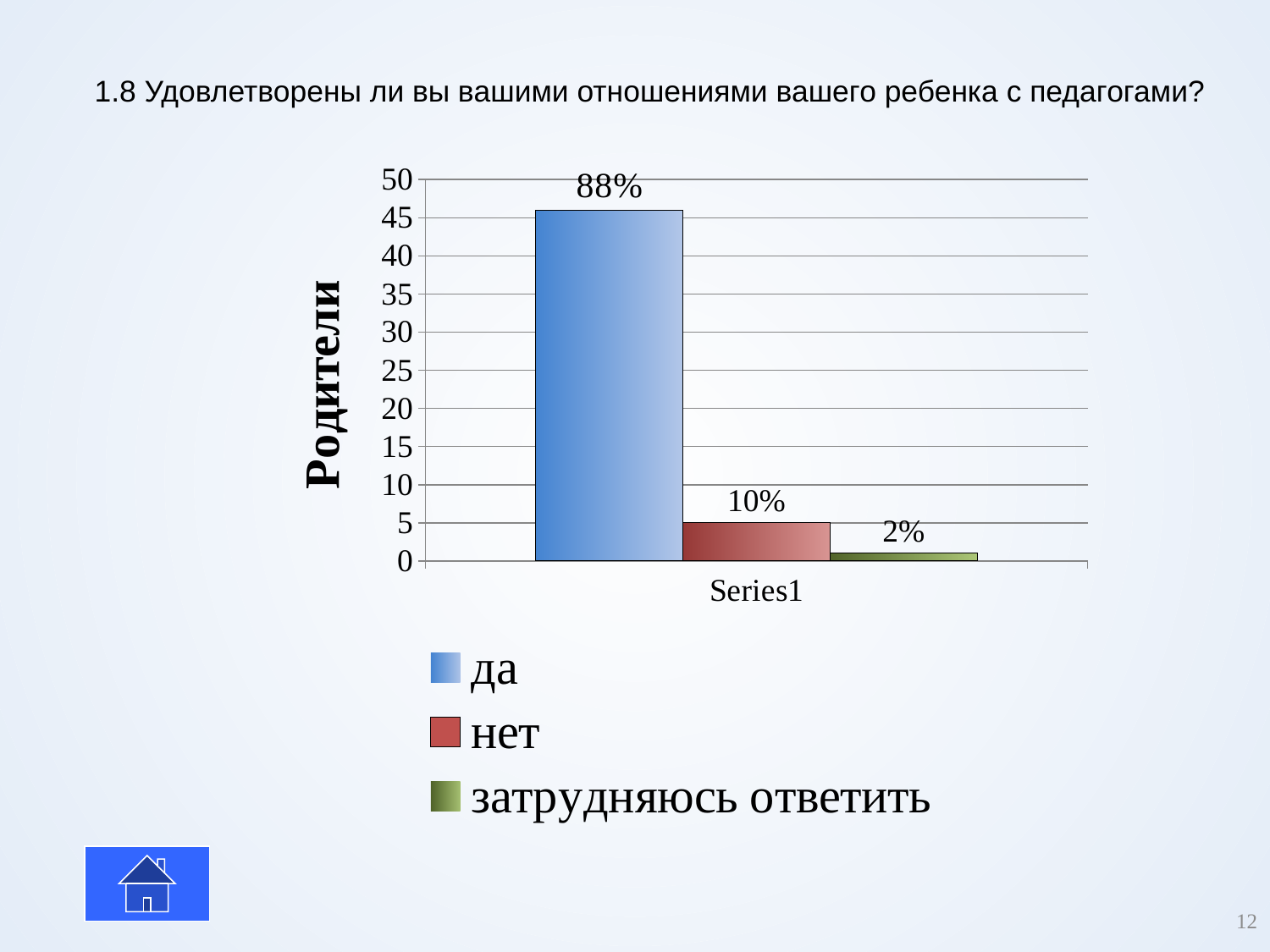
On the vertical axis, is the bar for "нет" greater or less than 10? less Which legend entry has the highest value? да What is the title of the vertical axis? Родители How many series does the legend list? 3 On the vertical axis, is the bar for "да" greater or less than 40? greater What data label is shown on the bar for "да"? 88% What kind of chart is shown on the slide? bar chart What data label is shown on the bar for "нет"? 10% Which legend entry has the lowest value? затрудняюсь ответить Which is larger, the value for "нет" or the value for "затрудняюсь ответить"? нет What data label is shown on the bar for "затрудняюсь ответить"? 2% What is the difference between the labelled values for "да" and "нет"? 78%